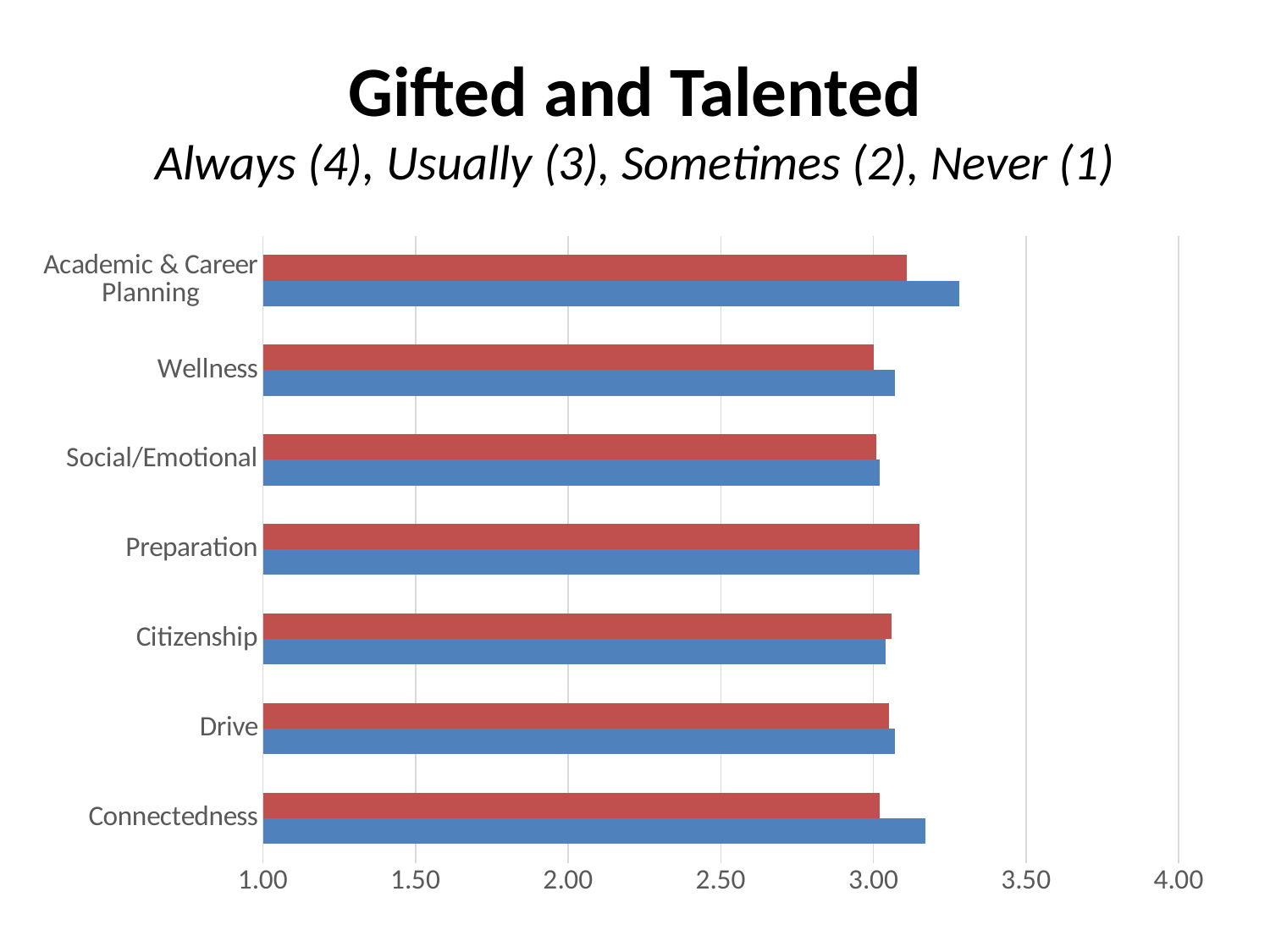
For Connectedness, which bar is longer, the red one or the blue one? blue How many bars are plotted for each category in the chart? 2 What is the title of the chart on the slide? Gifted and Talented Is the blue bar for Connectedness greater or less than 3.50? less For Academic & Career Planning, which bar is longer, the red one or the blue one? blue What kind of chart is shown on the slide? bar chart Is the blue bar for Academic & Career Planning greater or less than 3.50? less Is the red bar for Preparation greater or less than 3.00? greater How many categories are shown on the vertical axis of the chart? 7 Which category has the longest blue bar? Academic & Career Planning What is the highest value shown on the horizontal axis of the chart? 4.00